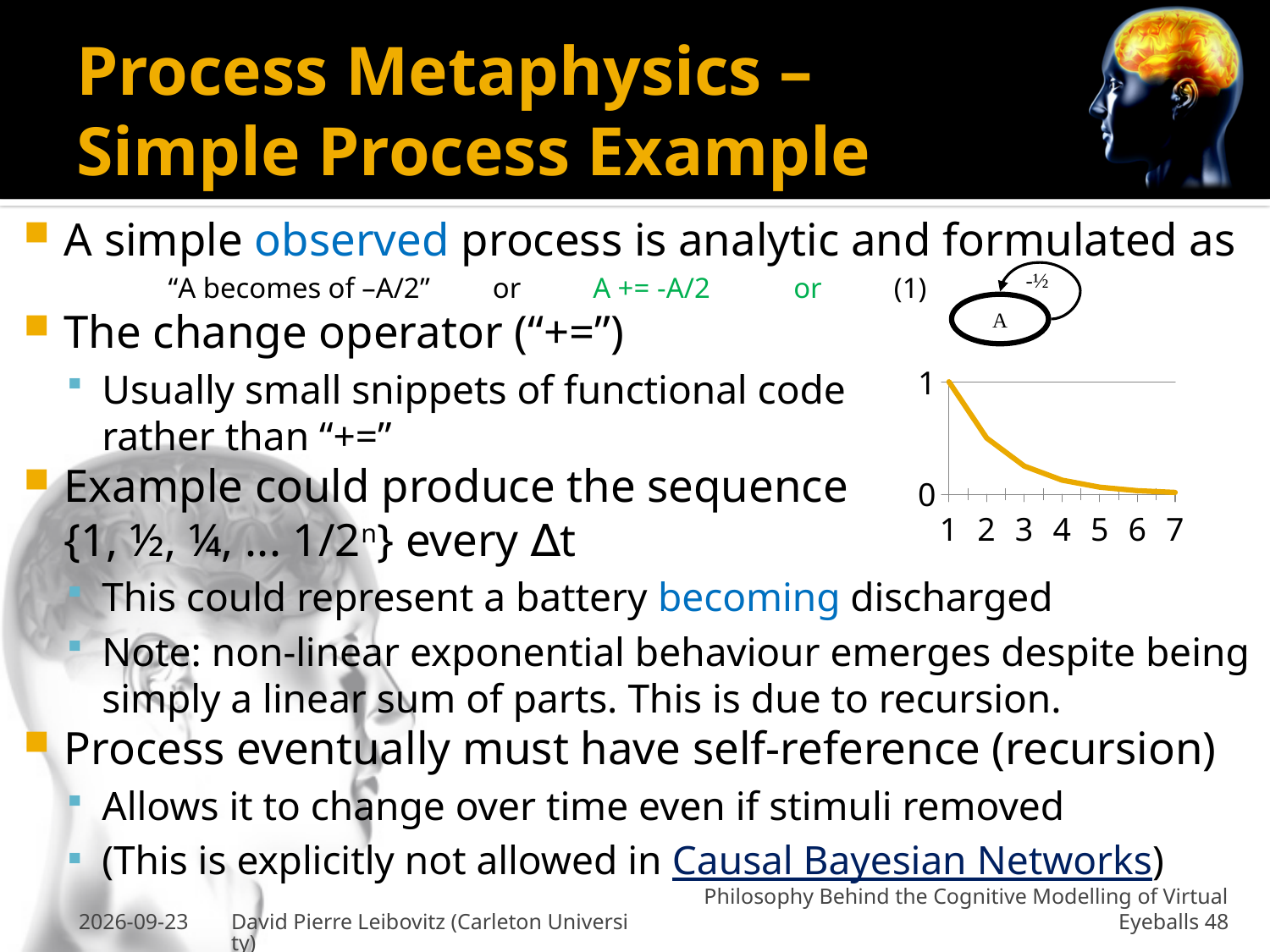
Is the plotted value at x = 2 greater or less than 1? less How many lines are plotted in the chart? 1 At which x value is the plotted value highest? 1 Which has the larger plotted value, x = 1 or x = 3? 1 Do the values in the chart rise or fall as the x axis goes from 1 to 7? fall What is the highest value labelled on the y axis of the chart? 1 Which has the larger plotted value, x = 2 or x = 5? 2 How many points are plotted along the x axis of the chart? 7 Is the plotted value at x = 4 greater or less than 1? less What is the plotted value at x = 1? 1 What kind of chart is shown on the slide? line chart What colour is the line in the chart? orange